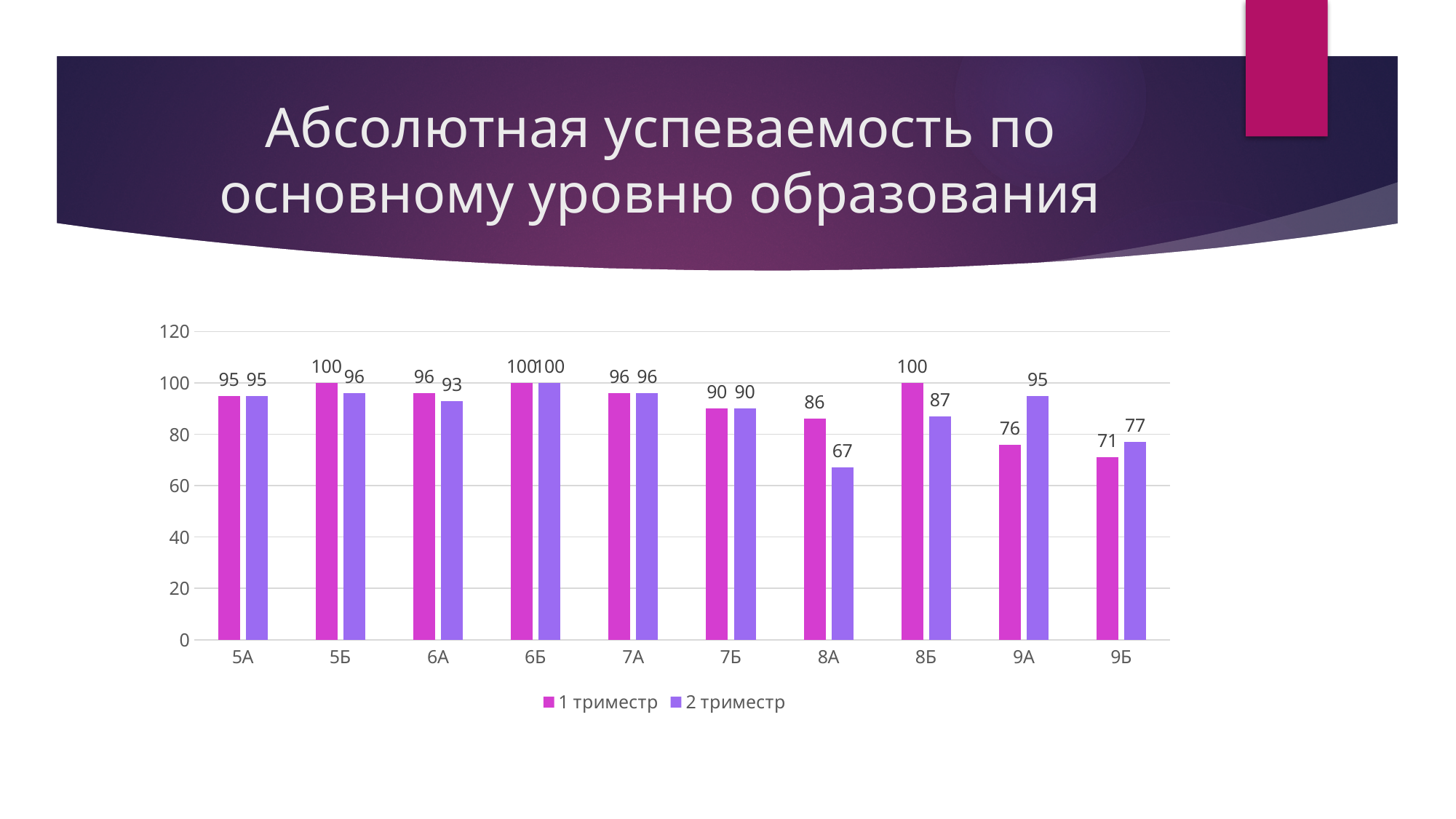
What is the value for 9А in the 2 триместр series? 95 How many categories are shown on the x axis? 10 Which category has the lowest value in the 1 триместр series? 9Б How many series does the legend list? 2 What is the difference between the 1 триместр and 2 триместр values for 9А? 19 Which is larger for 9Б: the 1 триместр value or the 2 триместр value? 2 триместр What is the difference between the 1 триместр and 2 триместр values for 8А? 19 What is the value for 6А in the 2 триместр series? 93 Which category has the lowest value in the 2 триместр series? 8А What is the value for 8А in the 1 триместр series? 86 Which is larger for 8Б: the 1 триместр value or the 2 триместр value? 1 триместр What kind of chart is shown on the slide? Bar chart